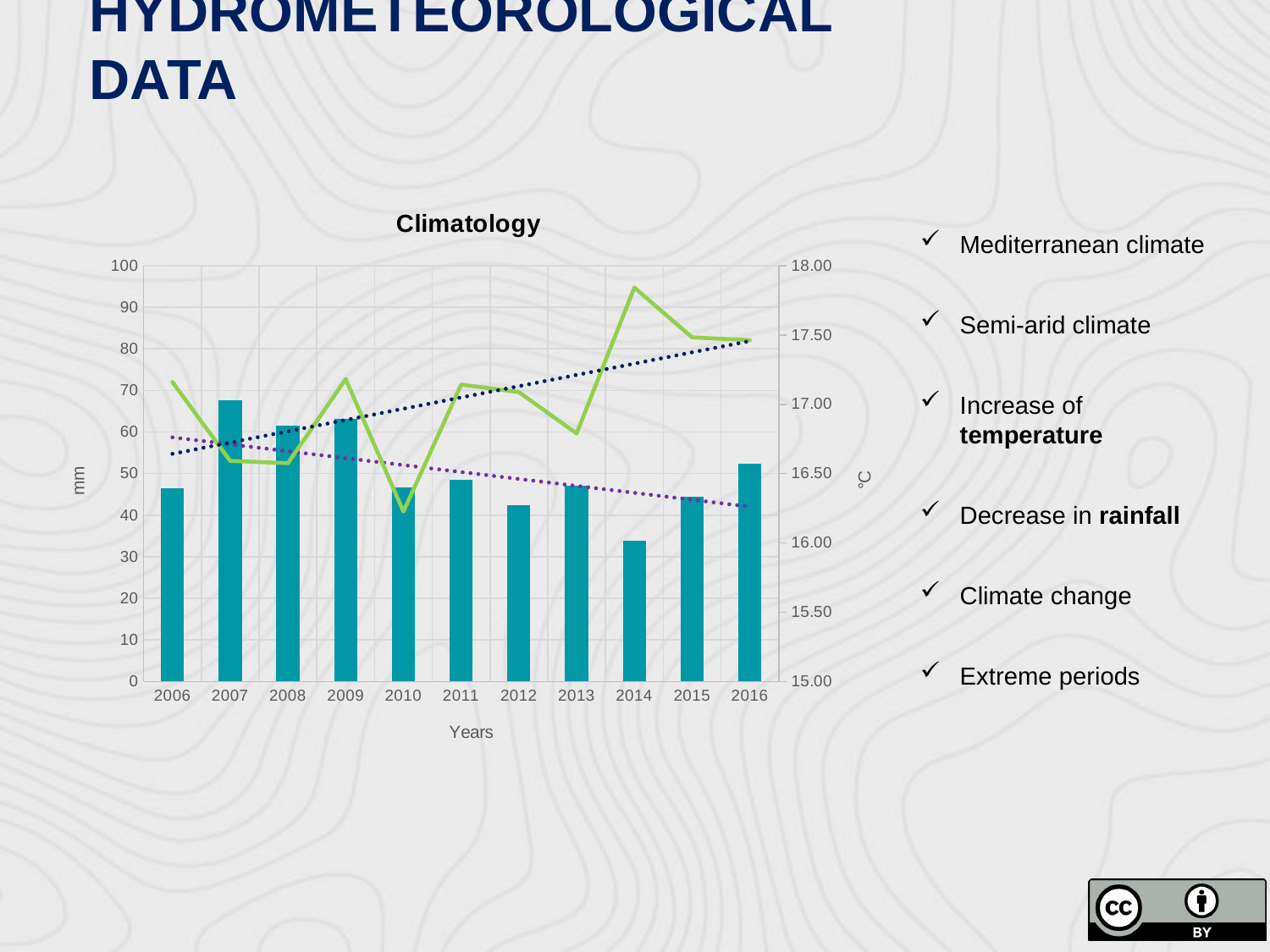
Is the temperature line value for 2010 in the Climatology chart greater or less than 16.50 °C? less Is the bar value for 2014 in the Climatology chart greater or less than 40 mm? less What kind of chart is the Climatology chart? A combined bar and line chart What is the label of the left vertical axis in the Climatology chart? mm In the Climatology chart, which year has a taller bar, 2009 or 2012? 2009 Is the bar value for 2016 in the Climatology chart greater or less than 50 mm? greater Which year has the tallest bar in the Climatology chart? 2007 How many years are shown on the x axis of the Climatology chart? 11 In which year does the green temperature line reach its highest point in the Climatology chart? 2014 Which year has the shortest bar in the Climatology chart? 2014 What is the title of the chart on the slide? Climatology